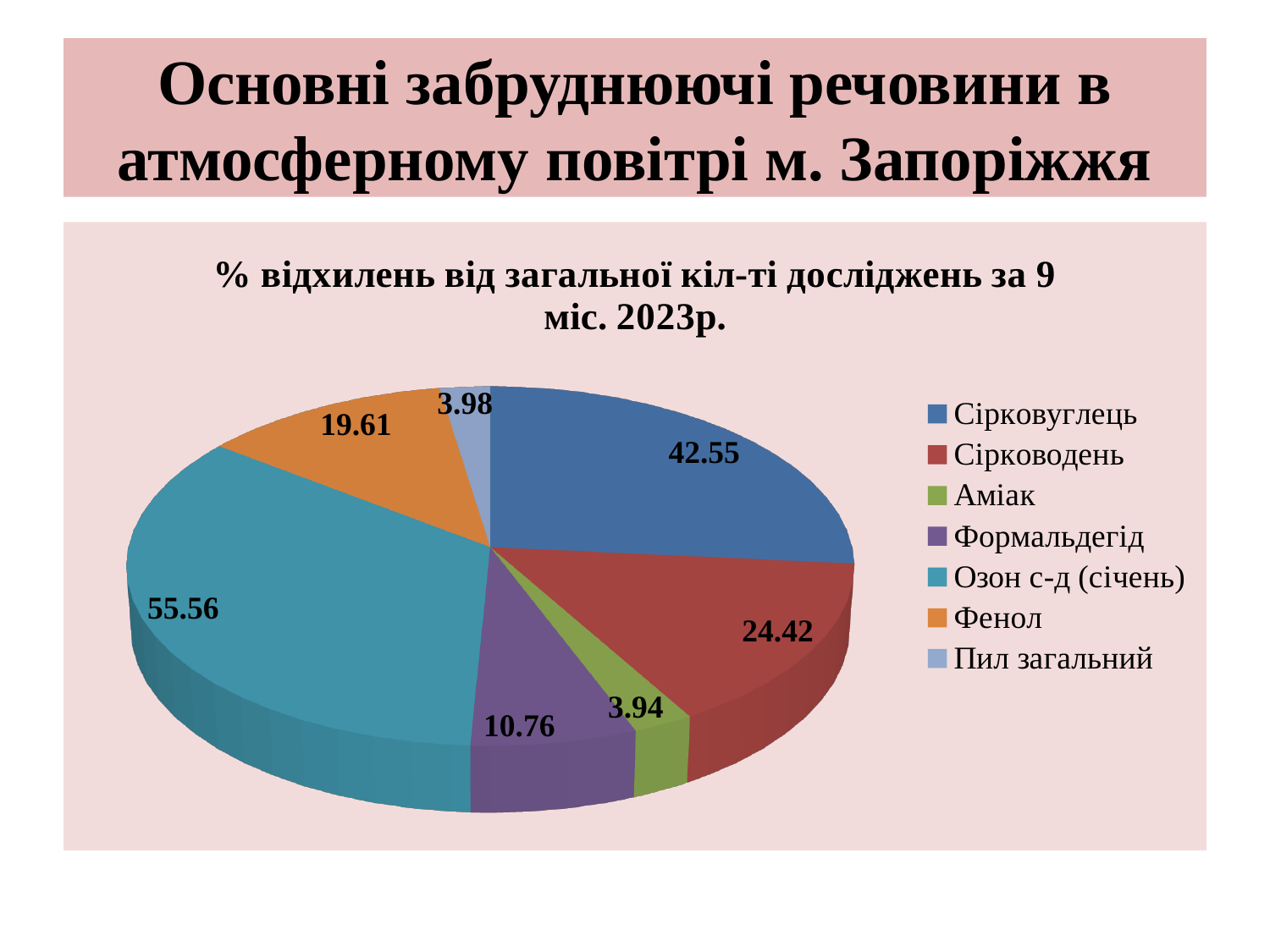
What is the value shown for Озон с-д (січень)? 55.56 What is the difference between the values for Озон с-д (січень) and Сірковуглець? 13.01 What is the difference between the values for Сірковуглець and Сірководень? 18.13 What is the value shown for Формальдегід? 10.76 How many categories are shown in the pie chart? 7 What is the title of the chart? % відхилень від загальної кіл-ті досліджень за 9 міс. 2023р. What type of chart is shown on the slide? Pie chart What is the value shown for Сірковуглець? 42.55 What is the value shown for Сірководень? 24.42 What is the value shown for Фенол? 19.61 Which category has the largest value in the pie chart? Озон с-д (січень) Which has a larger value, Фенол or Формальдегід? Фенол